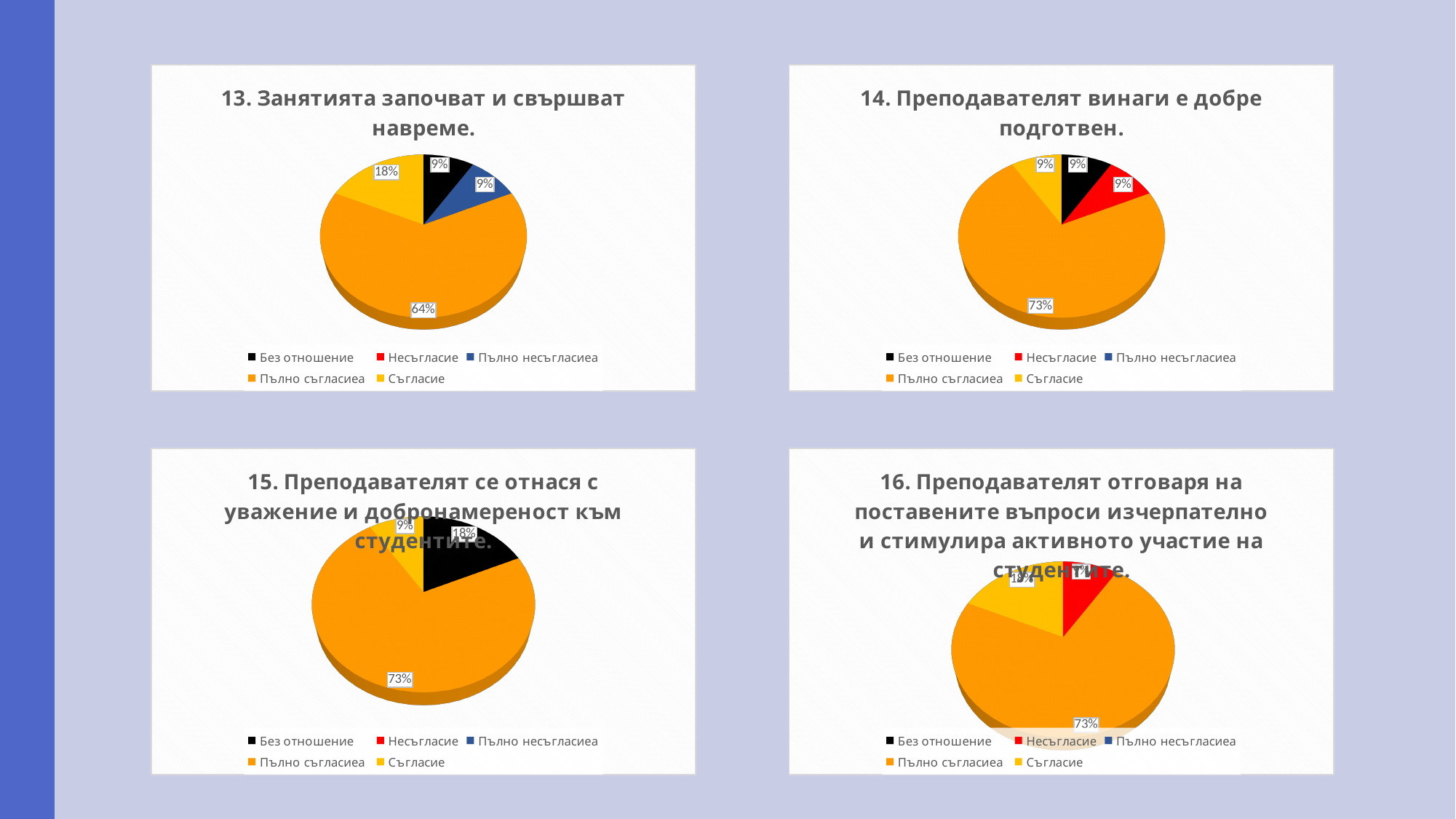
In the chart titled "15. Преподавателят се отнася с уважение и добронамереност към студентите.", which category has the smallest share? Съгласие How many entries does the legend list in the chart titled "14. Преподавателят винаги е добре подготвен."? 5 How many charts are shown on the slide? 4 In the bottom-right chart (question 16), what percentage is shown for Съгласие? 18% In the chart titled "13. Занятията започват и свършват навреме.", which category has the largest share? Пълно съгласиеа In the chart titled "15. Преподавателят се отнася с уважение и добронамереност към студентите.", what percentage is shown for Без отношение? 18% What type of chart is used for "13. Занятията започват и свършват навреме."? Pie chart In the chart titled "14. Преподавателят винаги е добре подготвен.", which is larger: the share for Пълно съгласиеа or the share for Несъгласие? Пълно съгласиеа In the chart titled "13. Занятията започват и свършват навреме.", what percentage is shown for Съгласие? 18% In the chart titled "13. Занятията започват и свършват навреме.", what percentage is shown for Пълно съгласиеа? 64% In the chart titled "13. Занятията започват и свършват навреме.", what is the difference between the shares for Пълно съгласиеа and Съгласие? 46% In the chart titled "14. Преподавателят винаги е добре подготвен.", what percentage is shown for Пълно съгласиеа? 73%